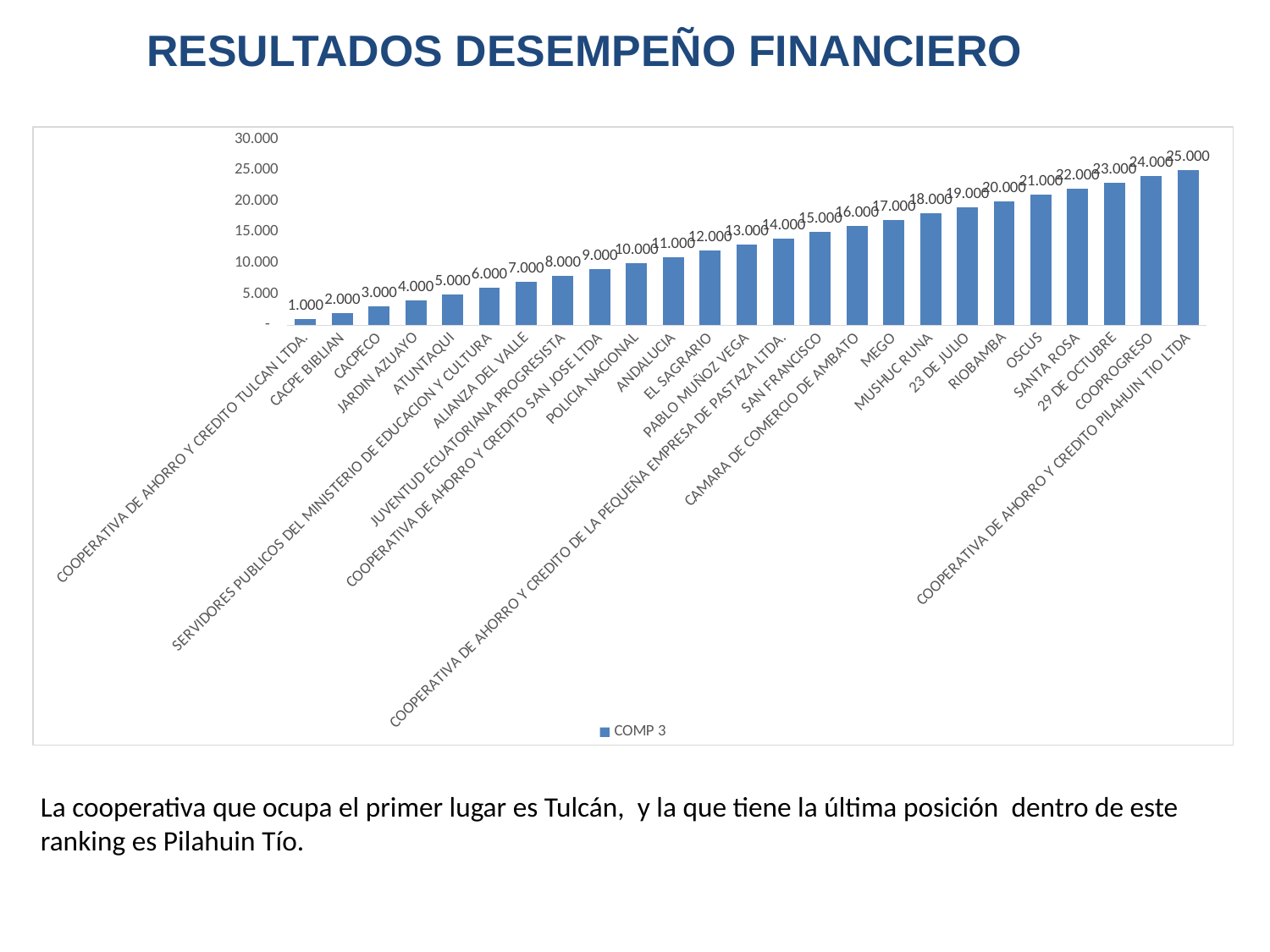
What is the value for POLICIA NACIONAL? 10.000 Is the value for SAN FRANCISCO greater or less than 10.000? greater Which category has the lowest value? COOPERATIVA DE AHORRO Y CREDITO TULCAN LTDA. How many categories are shown on the x axis? 25 What is the difference between the values for COOPROGRESO and EL SAGRARIO? 12.000 What is the value for MUSHUC RUNA? 18.000 Which has a larger value, OSCUS or ATUNTAQUI? OSCUS How many series does the legend list? 1 What kind of chart is shown on the slide? bar chart What is the value for JARDIN AZUAYO? 4.000 Which category has the highest value? COOPERATIVA DE AHORRO Y CREDITO PILAHUIN TIO LTDA Do the values rise or fall from left to right along the x axis? rise